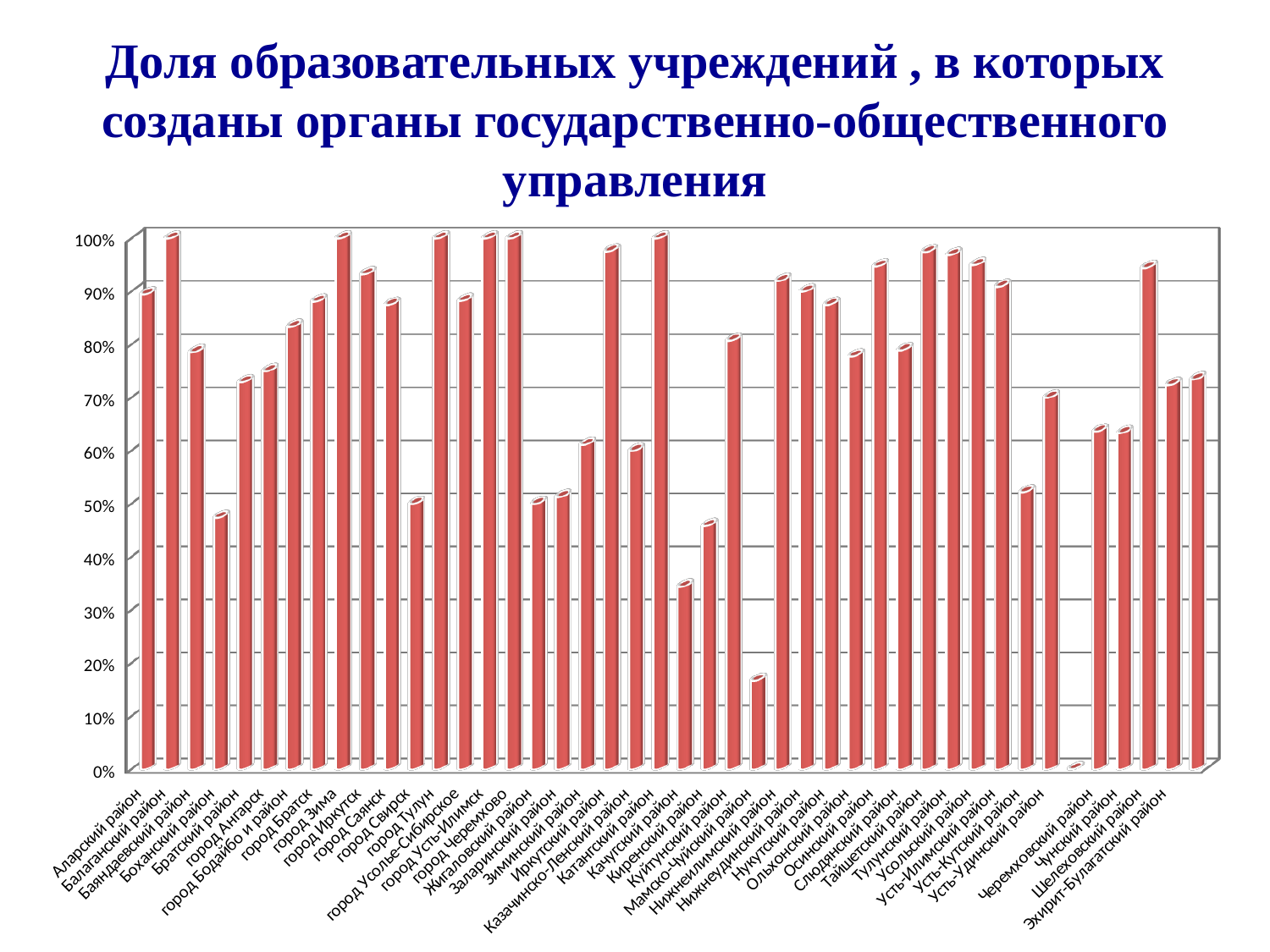
Is the value for Балаганский район greater or less than 90%? greater Is the value for Аларский район greater or less than 80%? greater What is the highest value shown on the vertical axis? 100% What is the title of the chart? Доля образовательных учреждений, в которых созданы органы государственно-общественного управления Which is larger, the value for Балаганский район or for Баяндаевский район? Балаганский район Which is larger, the value for Аларский район or for Боханский район? Аларский район What kind of chart is shown on the slide? bar chart Is the value for Боханский район greater or less than 60%? less